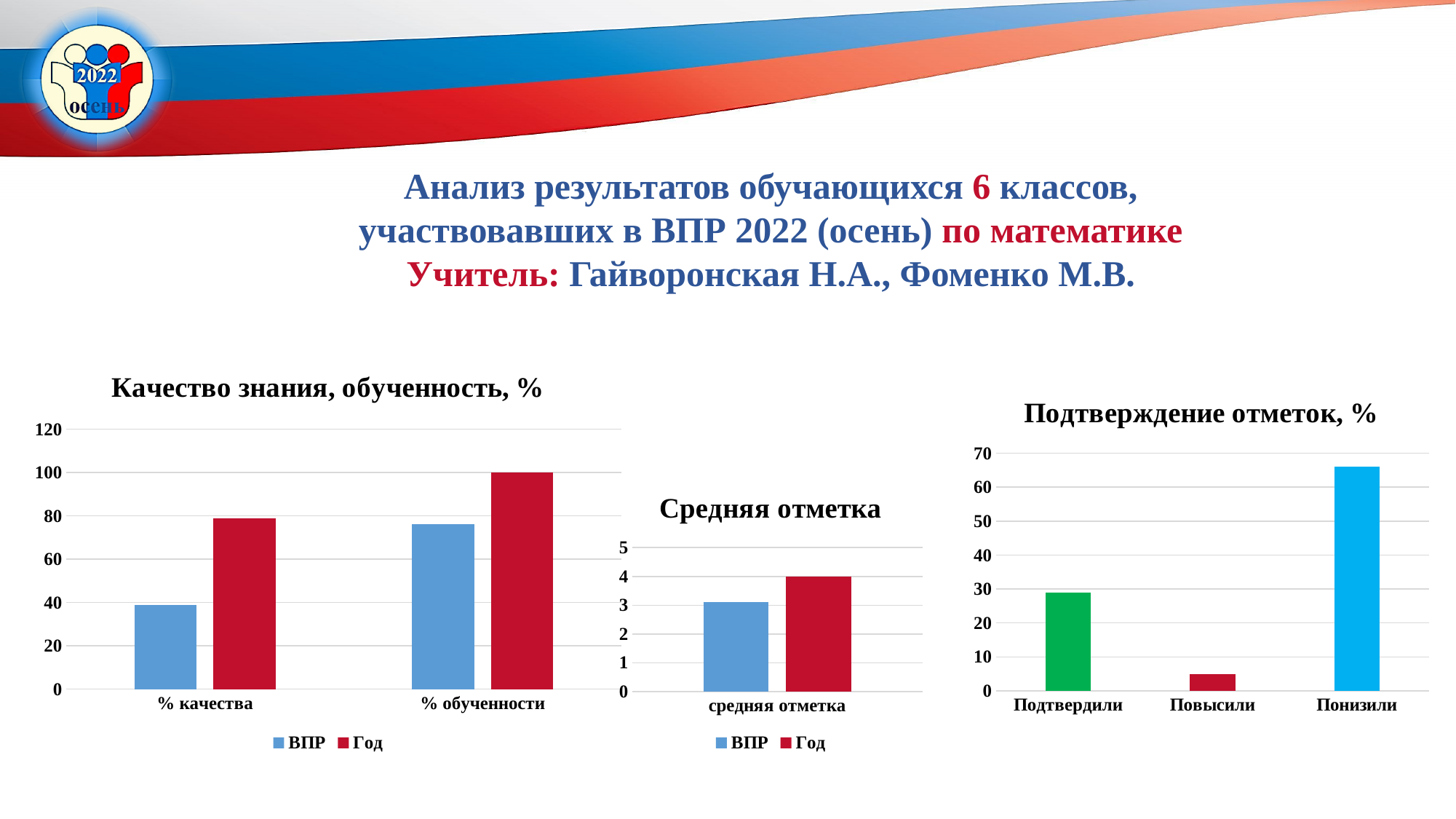
What kind of chart is the 'Качество знания, обученность, %' chart? bar chart In the 'Качество знания, обученность, %' chart, what is the value of Год for % обученности? 100 In the 'Подтверждение отметок, %' chart, is the value for Понизили greater or less than 60? greater In the 'Качество знания, обученность, %' chart, how many series does the legend list? 2 In the 'Подтверждение отметок, %' chart, which category has the lowest value? Повысили In the 'Подтверждение отметок, %' chart, how many categories are shown? 3 In the 'Средняя отметка' chart, which series is larger, ВПР or Год? Год In the 'Качество знания, обученность, %' chart, which series is larger for % качества, ВПР or Год? Год In the 'Качество знания, обученность, %' chart, is the value of ВПР for % обученности greater or less than 60? greater In the 'Подтверждение отметок, %' chart, which category has the highest value? Понизили In the 'Средняя отметка' chart, what is the value of Год? 4